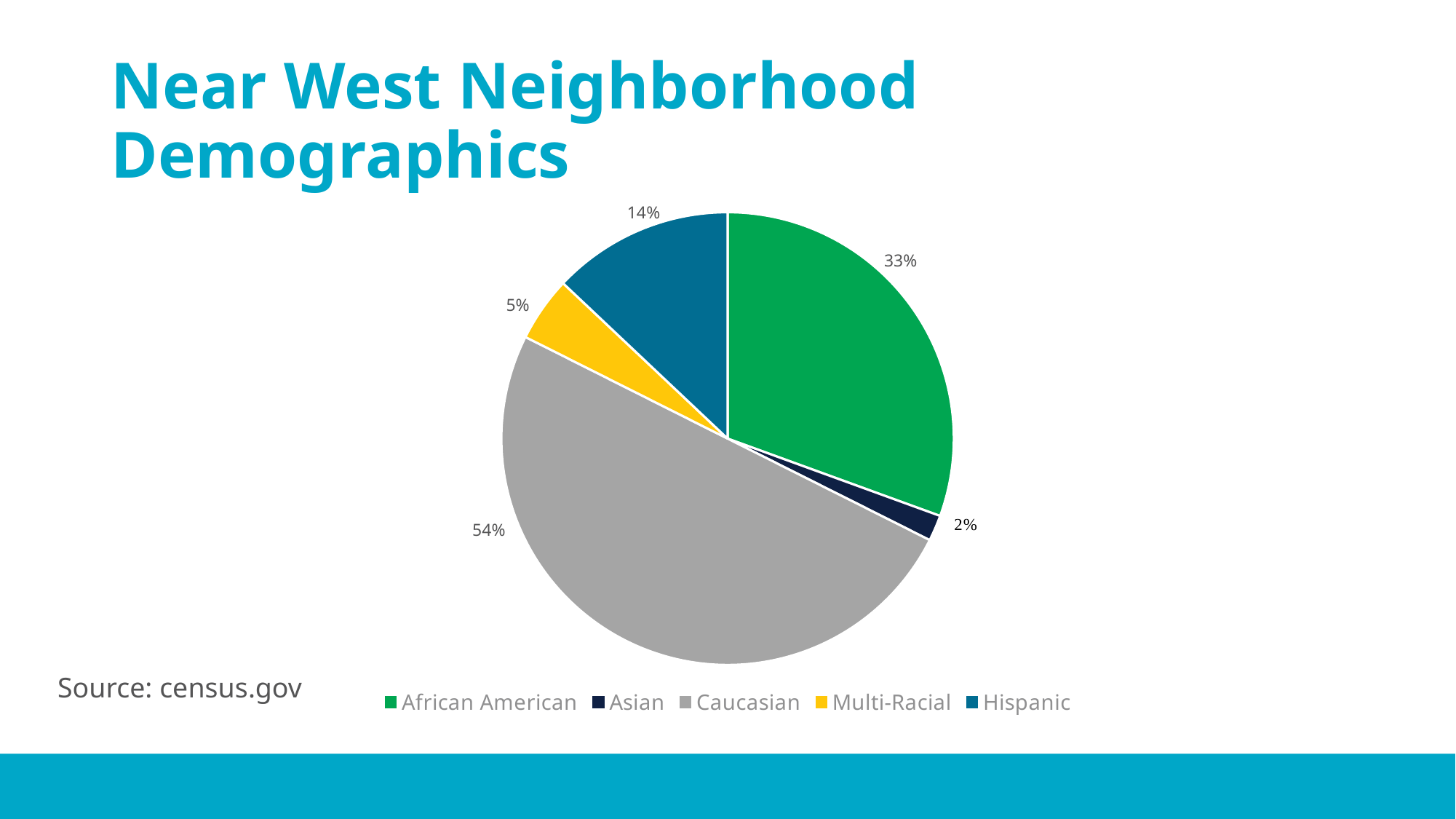
Which is larger, the Hispanic slice or the Multi-Racial slice? Hispanic Which category has the largest slice of the pie? Caucasian What share of the pie does Multi-Racial represent? 5% What type of chart is shown on the slide? Pie chart What share of the pie does African American represent? 33% What share of the pie does Caucasian represent? 54% How many categories does the pie chart show? 5 Which category has the smallest slice of the pie? Asian What is the title of the slide containing the chart? Near West Neighborhood Demographics What is the difference in percentage points between the Caucasian and African American slices? 21